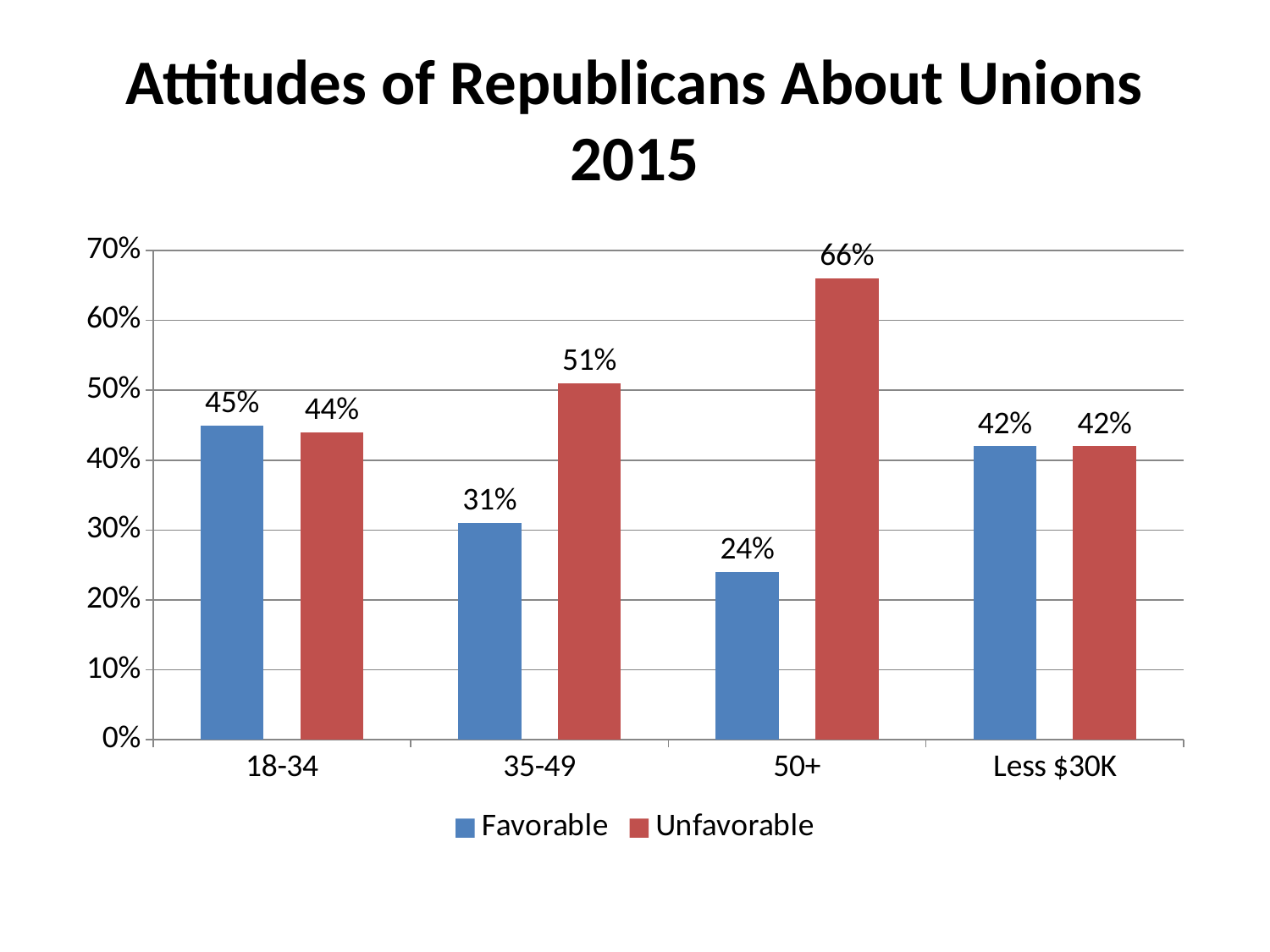
What is the title of the chart? Attitudes of Republicans About Unions 2015 How many categories are shown on the x axis? 4 Which is larger for the 35-49 group, Favorable or Unfavorable? Unfavorable Which category has the highest Unfavorable value? 50+ What kind of chart is shown on the slide? Bar chart Which category has the lowest Favorable value? 50+ What is the Unfavorable value for the 50+ group? 66% What is the difference between the Unfavorable and Favorable values for the 50+ group? 42% What is the Favorable value for the 35-49 group? 31% How many series does the legend list? 2 What is the Favorable value for the 18-34 group? 45% What colour are the Unfavorable bars? Red